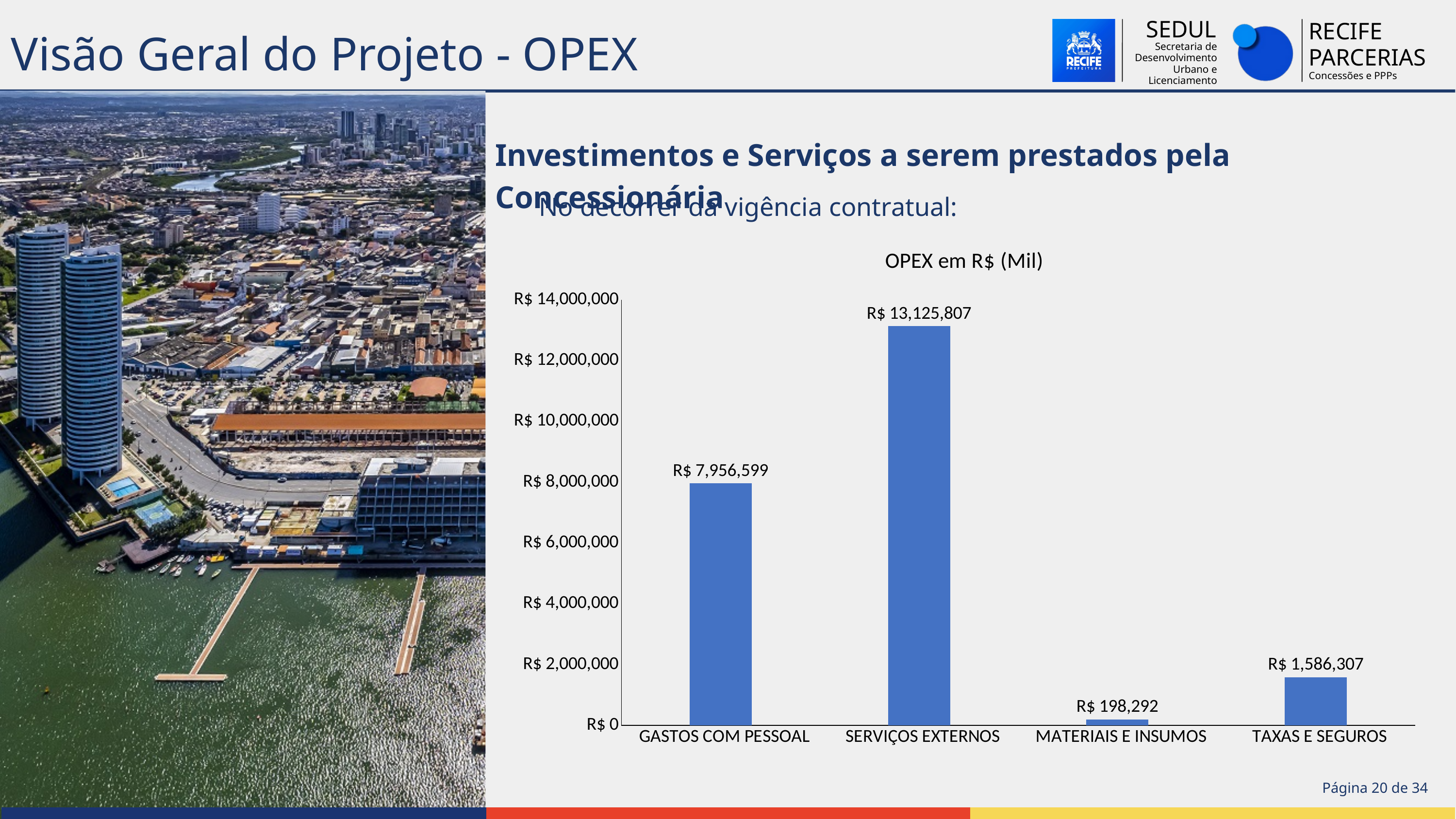
What is the value for GASTOS COM PESSOAL in the OPEX em R$ (Mil) chart? R$ 7,956,599 How many categories are shown in the OPEX em R$ (Mil) chart? 4 What is the value for MATERIAIS E INSUMOS in the OPEX em R$ (Mil) chart? R$ 198,292 What is the value for TAXAS E SEGUROS in the OPEX em R$ (Mil) chart? R$ 1,586,307 Which is larger in the OPEX em R$ (Mil) chart: GASTOS COM PESSOAL or TAXAS E SEGUROS? GASTOS COM PESSOAL Is the value for SERVIÇOS EXTERNOS greater or less than R$ 12,000,000? greater What type of chart is used to show OPEX em R$ (Mil)? Bar chart What is the value for SERVIÇOS EXTERNOS in the OPEX em R$ (Mil) chart? R$ 13,125,807 What is the difference between TAXAS E SEGUROS and MATERIAIS E INSUMOS in the OPEX em R$ (Mil) chart? R$ 1,388,015 What is the difference between SERVIÇOS EXTERNOS and GASTOS COM PESSOAL in the OPEX em R$ (Mil) chart? R$ 5,169,208 Which category has the highest value in the OPEX em R$ (Mil) chart? SERVIÇOS EXTERNOS Which category has the lowest value in the OPEX em R$ (Mil) chart? MATERIAIS E INSUMOS